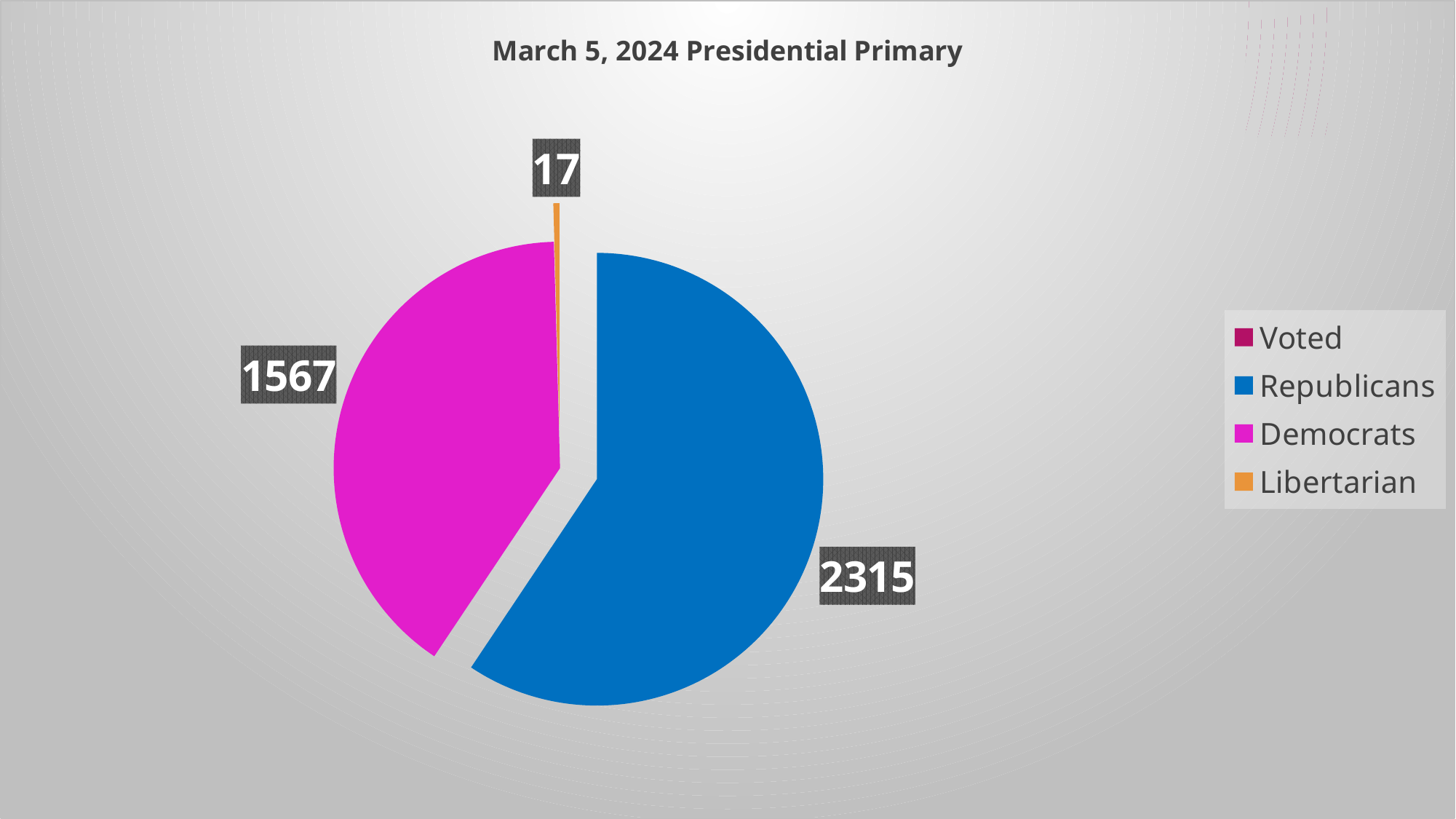
What is the value shown for Libertarian? 17 Which is larger, the value for Democrats or the value for Republicans? Republicans What colour is the Democrats slice? magenta What is the difference between the Democrats value and the Libertarian value? 1550 What type of chart is shown on the slide? pie chart What is the title of the chart? March 5, 2024 Presidential Primary What is the difference between the Republicans value and the Democrats value? 748 What is the value shown for Democrats? 1567 Which labelled slice has the smallest value? Libertarian Which category has the largest slice of the pie? Republicans How many entries does the legend list? 4 What is the value shown for Republicans? 2315